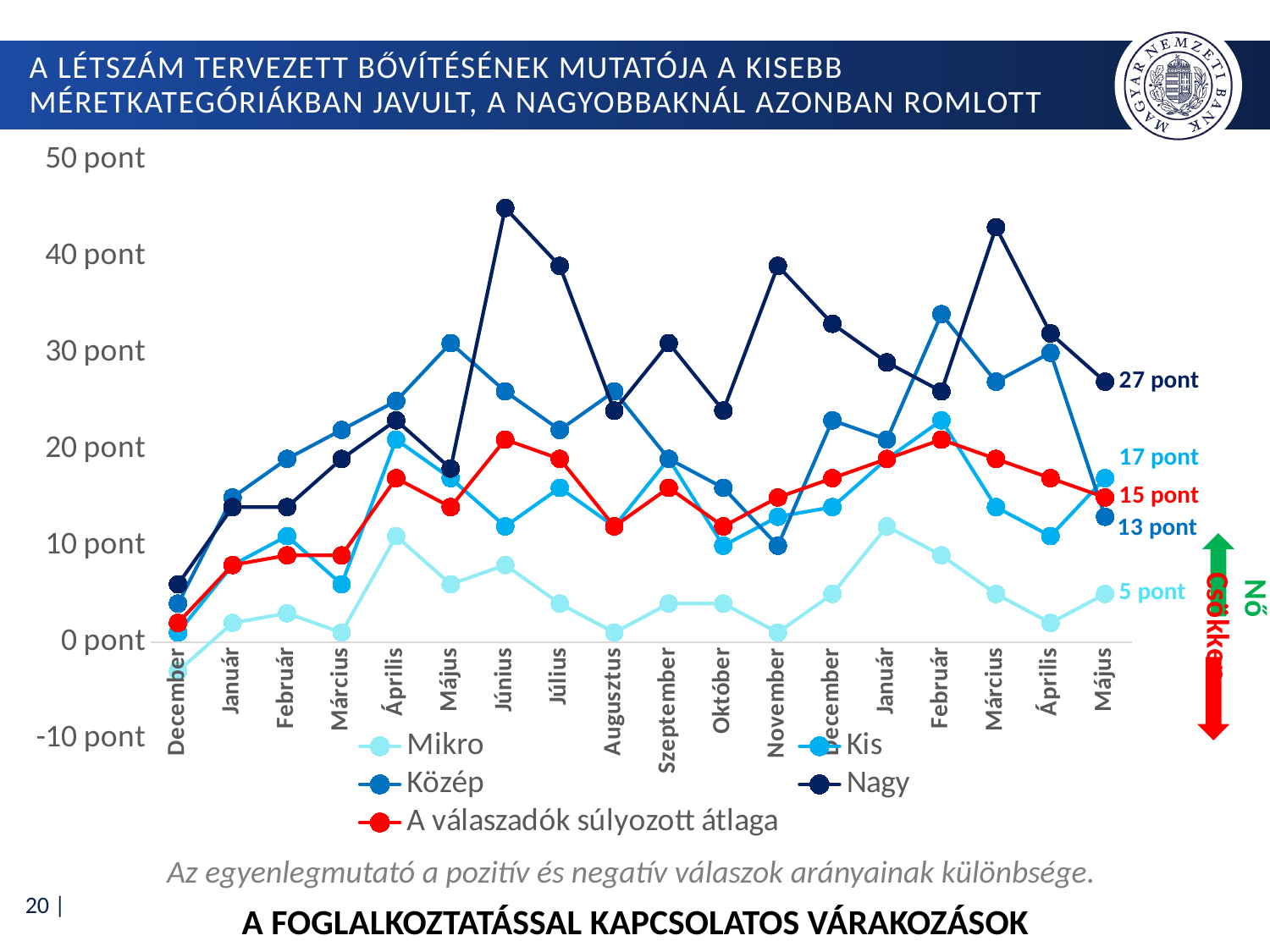
What kind of chart is shown on the slide? line chart Which series has the lowest value at the final Május point? Mikro How many months are plotted along the x axis? 18 At the final Május point, which is larger: Kis or Közép? Kis Which series is drawn in red? A válaszadók súlyozott átlaga Is the value for Nagy in Június greater or less than 40 pont? greater What is the value of 'A válaszadók súlyozott átlaga' at the final Május point? 15 pont How many series does the legend list? 5 Which series has the highest value at the final Május point? Nagy What is the value of the Mikro series at the final Május point? 5 pont What is the difference between the Nagy and Mikro values at the final Május point? 22 pont What is the value of the Nagy series at the final Május point? 27 pont